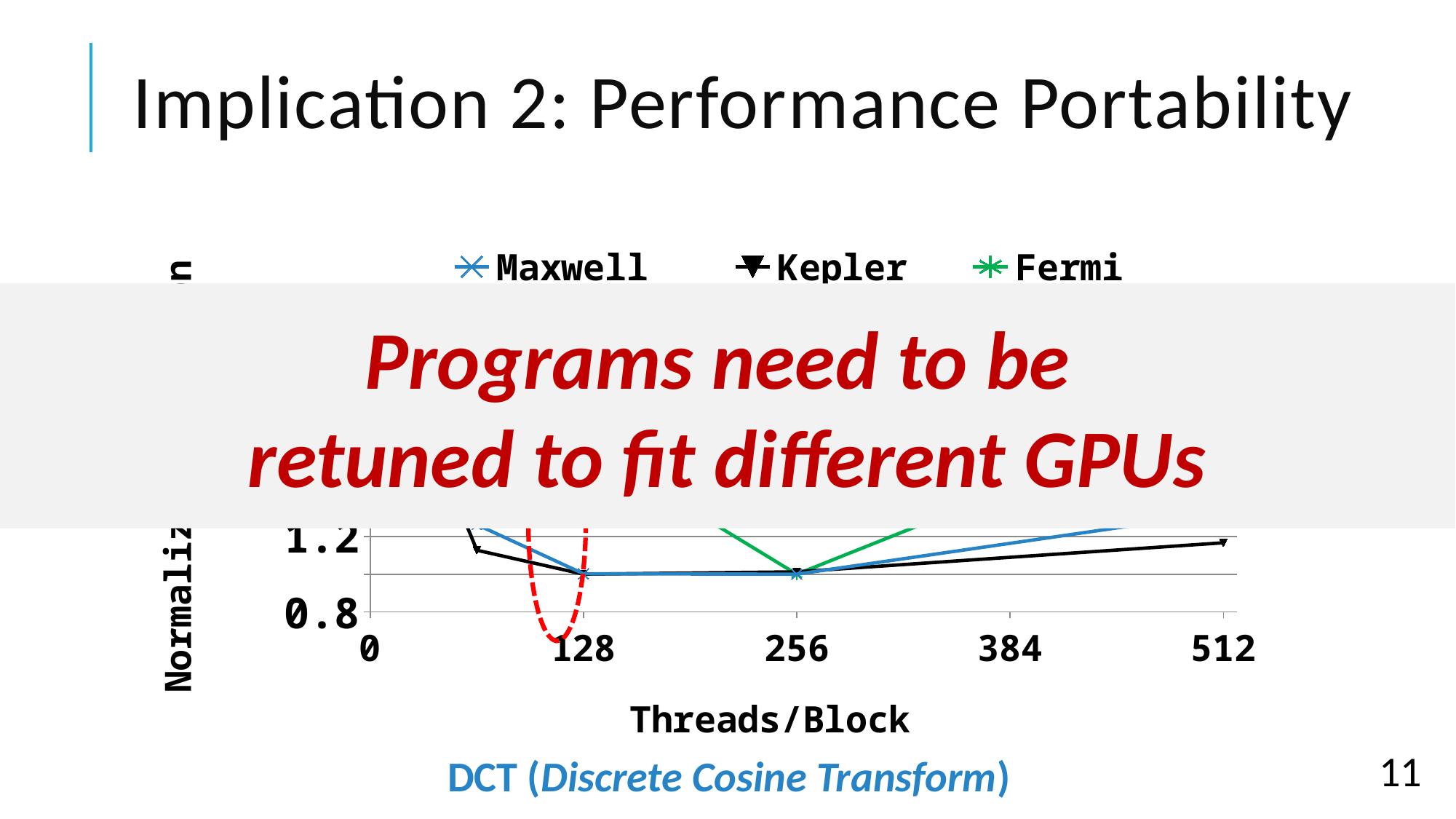
Is the value for Maxwell at 128 threads/block greater or less than 1.2? less How many tick labels are shown on the x axis? 5 Is the value for Fermi at 256 threads/block greater or less than 1.2? less Does the Maxwell series rise or fall between 256 and 512 threads/block? rise How many series does the chart's legend list? 3 What kind of chart is shown on the slide? line chart At 512 threads/block, which series has the higher value, Maxwell or Kepler? Maxwell What is the title of the chart's x axis? Threads/Block Which series are listed in the chart's legend? Maxwell, Kepler, Fermi Is the value for Kepler at 512 threads/block greater or less than 1.2? less At which threads/block value does the Fermi series reach its lowest point? 256